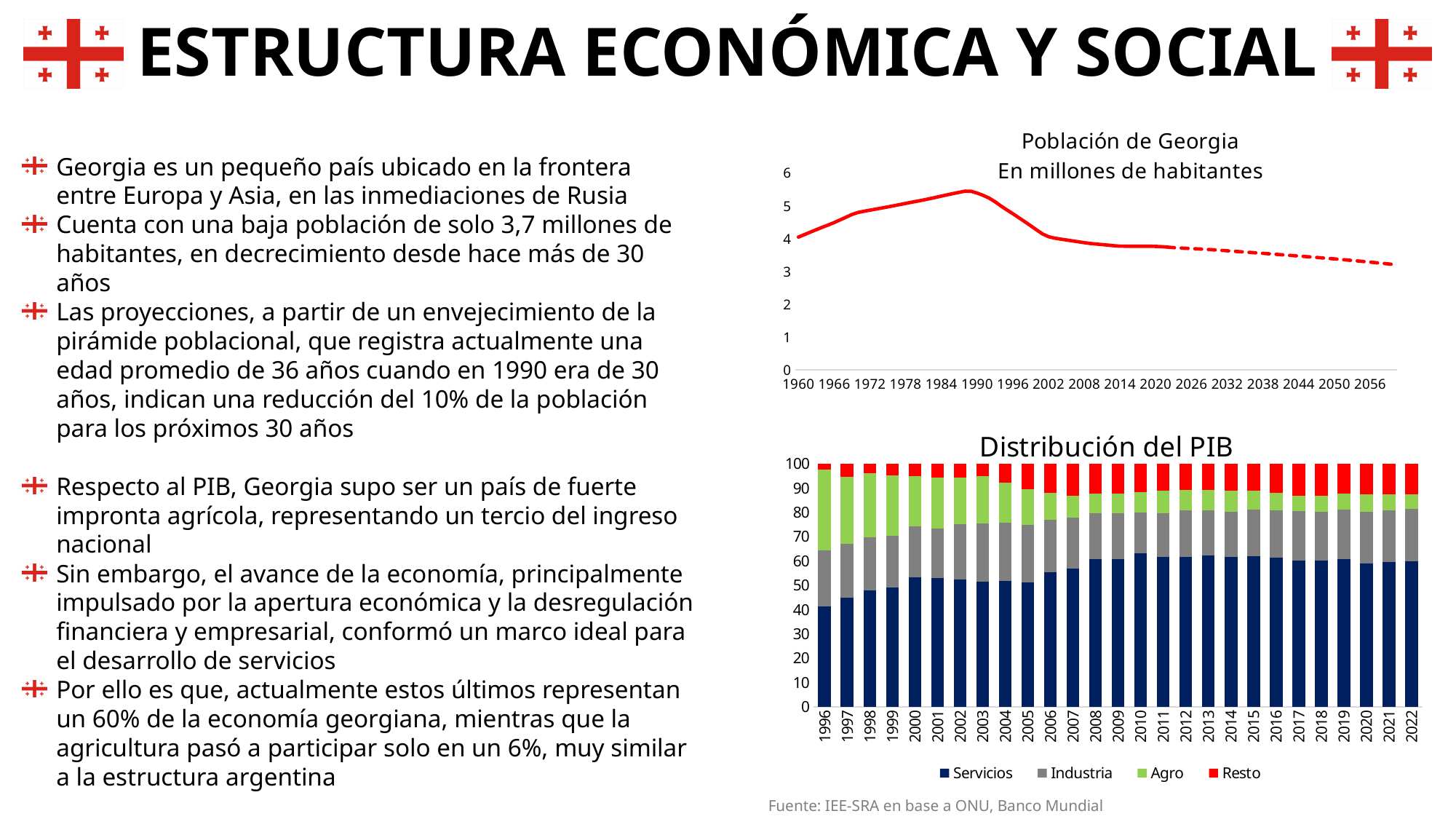
What kind of chart is the 'Población de Georgia' chart? line chart How many years are shown on the x axis of the 'Distribución del PIB' chart? 27 In the 'Población de Georgia' chart, does the population rise or fall from 1990 to 2056? fall In the 'Población de Georgia' chart, is the value for 1990 greater or less than 5? greater In the 'Población de Georgia' chart, which year shown has the highest population, 1990 or 2020? 1990 In the 'Distribución del PIB' chart, does the Agro share rise or fall from 1996 to 2022? fall What kind of chart is the 'Distribución del PIB' chart? stacked bar chart In the 'Población de Georgia' chart, is the value for 2056 greater or less than 4? less In the 'Distribución del PIB' chart, is the Servicios value for 1996 greater or less than 50? less In the 'Distribución del PIB' chart, which year has the largest Agro share? 1996 How many series does the legend of the 'Distribución del PIB' chart list? 4